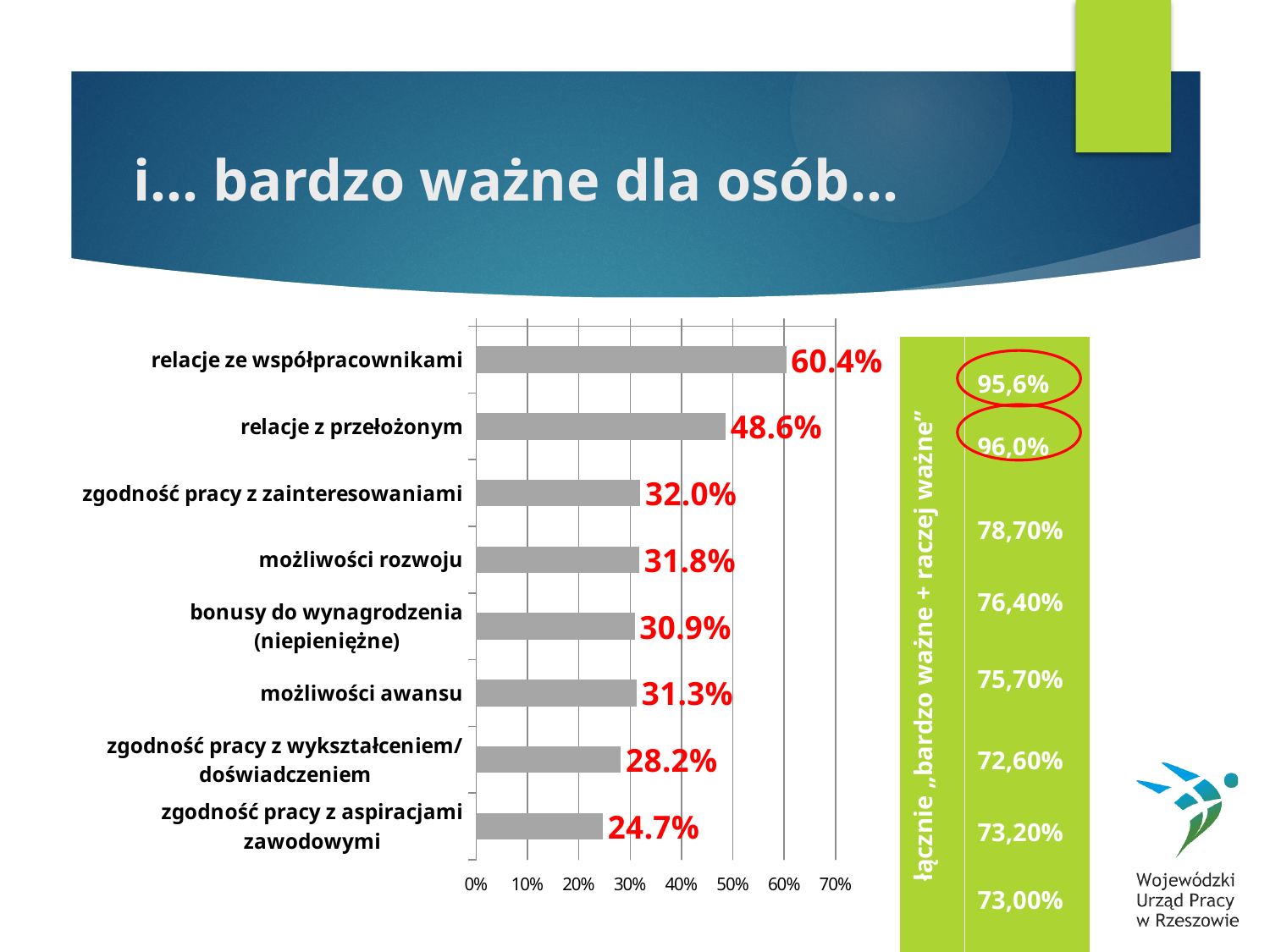
What is the value for "bonusy do wynagrodzenia (niepieniężne)"? 30.9% What is the difference between the values for "relacje ze współpracownikami" and "relacje z przełożonym"? 11.8 percentage points Which category has the lowest value in the bar chart? zgodność pracy z aspiracjami zawodowymi How many categories are shown in the bar chart? 8 What kind of chart is shown on the slide? bar chart What is the highest tick value shown on the x axis of the bar chart? 70% What is the value for "relacje ze współpracownikami"? 60.4% Is the value for "relacje z przełożonym" greater or less than 40%? greater What is the value for "zgodność pracy z aspiracjami zawodowymi"? 24.7% What colour are the bars in the chart? grey Which category has the highest value in the bar chart? relacje ze współpracownikami Which is larger: the value for "możliwości rozwoju" or for "możliwości awansu"? możliwości rozwoju